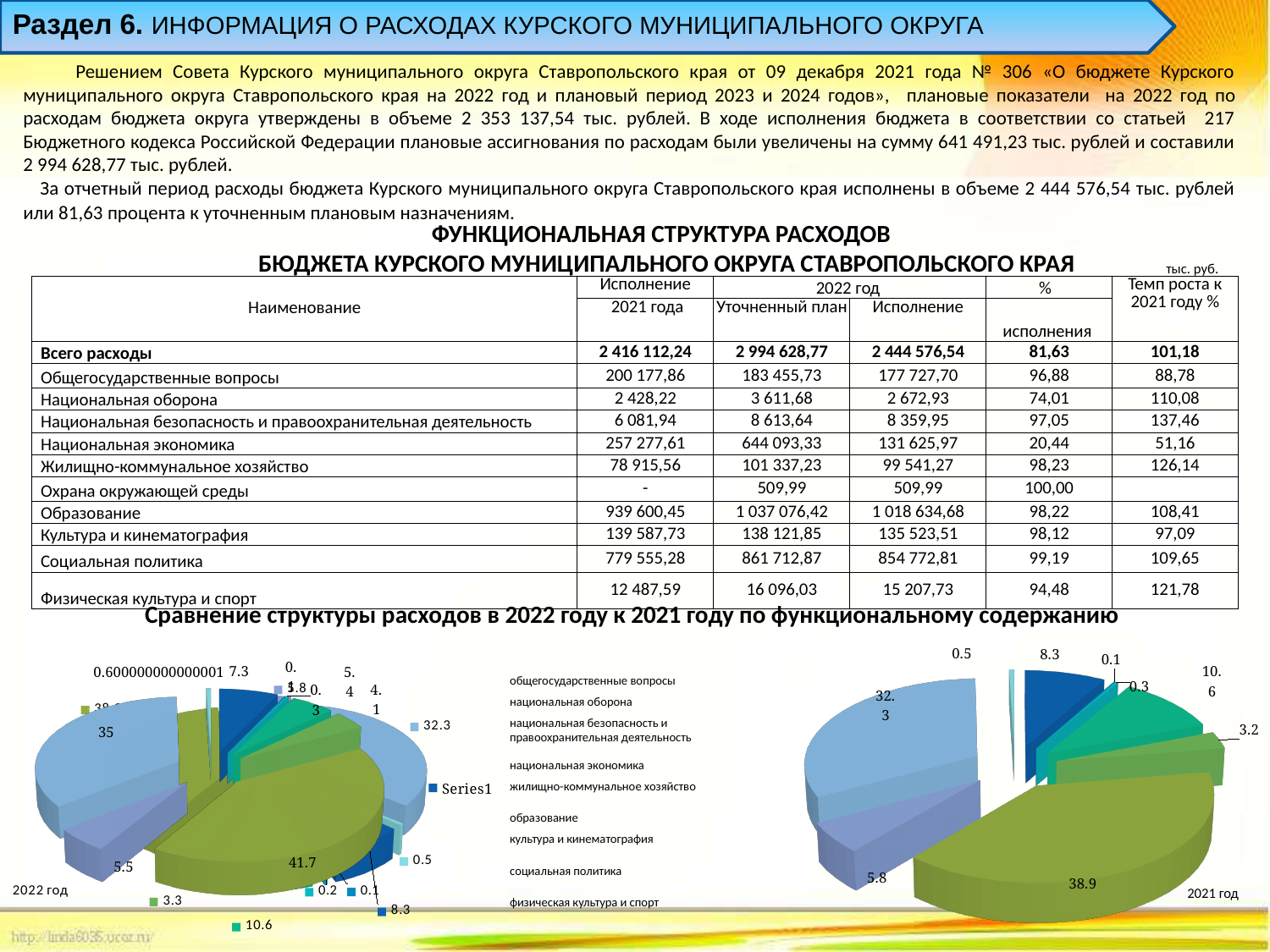
In the right-hand pie chart (2021 год), which is larger: the slice labelled 38.9 or the slice labelled 32.3? 38.9 How many charts are shown on the slide? 3 In the left-hand pie chart (2022 год), what is the value of the largest slice? 41.7 Which year does the right-hand pie chart represent? 2021 год How many slices does the right-hand pie chart (2021 год) have? 9 Which year does the left-hand pie chart represent? 2022 год In the right-hand pie chart (2021 год), what is the difference between the slices labelled 10.6 and 8.3? 2.3 In the right-hand pie chart (2021 год), what is the value of the largest slice? 38.9 In the right-hand pie chart (2021 год), what is the difference between the slices labelled 38.9 and 32.3? 6.6 How many expenditure categories are listed in the text legend between the two pie charts? 9 What kind of charts are shown at the bottom of the slide? Pie charts In the right-hand pie chart (2021 год), what is the value of the smallest labelled slice? 0.1